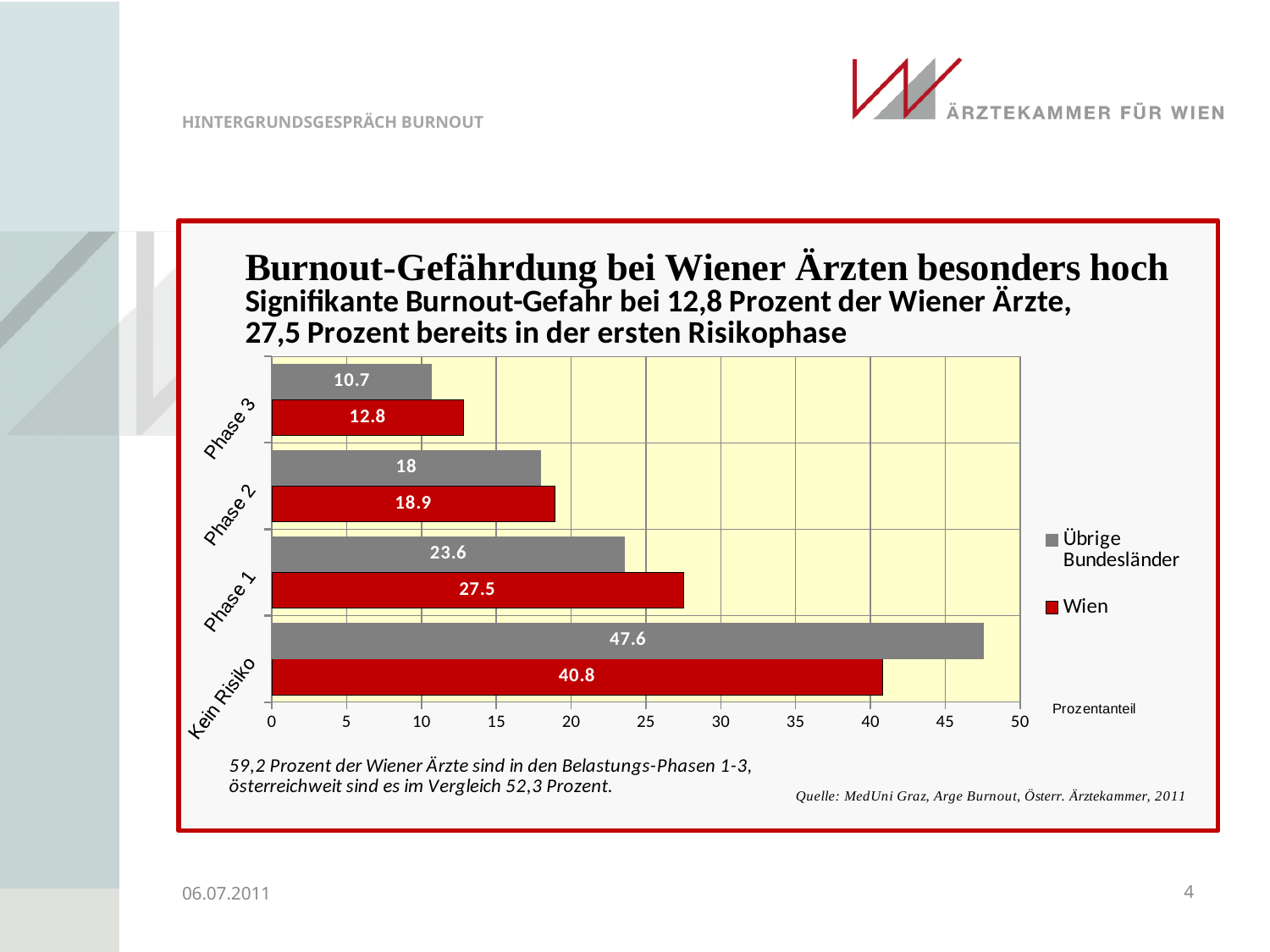
What is the difference between Übrige Bundesländer and Wien in the Kein Risiko category? 6.8 What is the value for Wien in Phase 1? 27.5 What is the value for Übrige Bundesländer in Phase 3? 10.7 Which category has the lowest value for the Übrige Bundesländer series? Phase 3 Which category has the highest value for the Wien series? Kein Risiko How many categories are shown on the chart? 4 In Phase 1, which is larger: the value for Wien or for Übrige Bundesländer? Wien What is the value for Übrige Bundesländer in Phase 2? 18 What is the value for Wien in the Kein Risiko category? 40.8 How many series does the legend list? 2 Which colour represents the Wien series in the chart? Red What kind of chart is shown on the slide? Bar chart